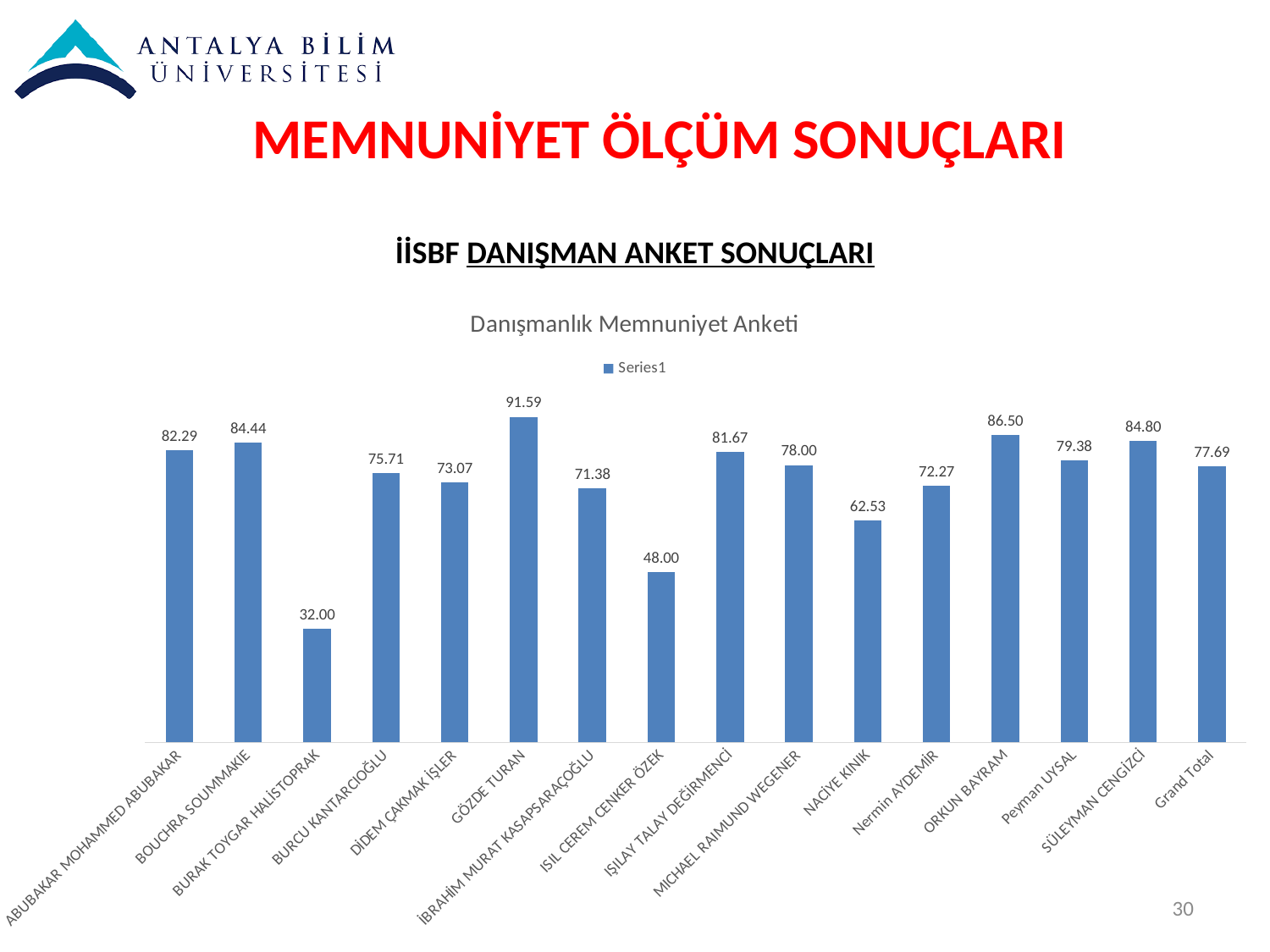
What is the title of the chart? Danışmanlık Memnuniyet Anketi What kind of chart is shown on the slide? Bar chart What is the value for NACİYE KINIK? 62.53 How many bars are shown in the chart? 16 What is the value for GÖZDE TURAN? 91.59 What is the value for Grand Total? 77.69 What is the difference between the values for ORKUN BAYRAM and Peyman UYSAL? 7.12 How many series does the legend list? 1 Which is larger, the value for BOUCHRA SOUMMAKIE or the value for SÜLEYMAN CENGİZCİ? SÜLEYMAN CENGİZCİ What is the difference between the values for IŞIL CEREM CENKER ÖZEK and BURAK TOYGAR HALİSTOPRAK? 16.00 Which category has the lowest value? BURAK TOYGAR HALİSTOPRAK Which category has the highest value? GÖZDE TURAN